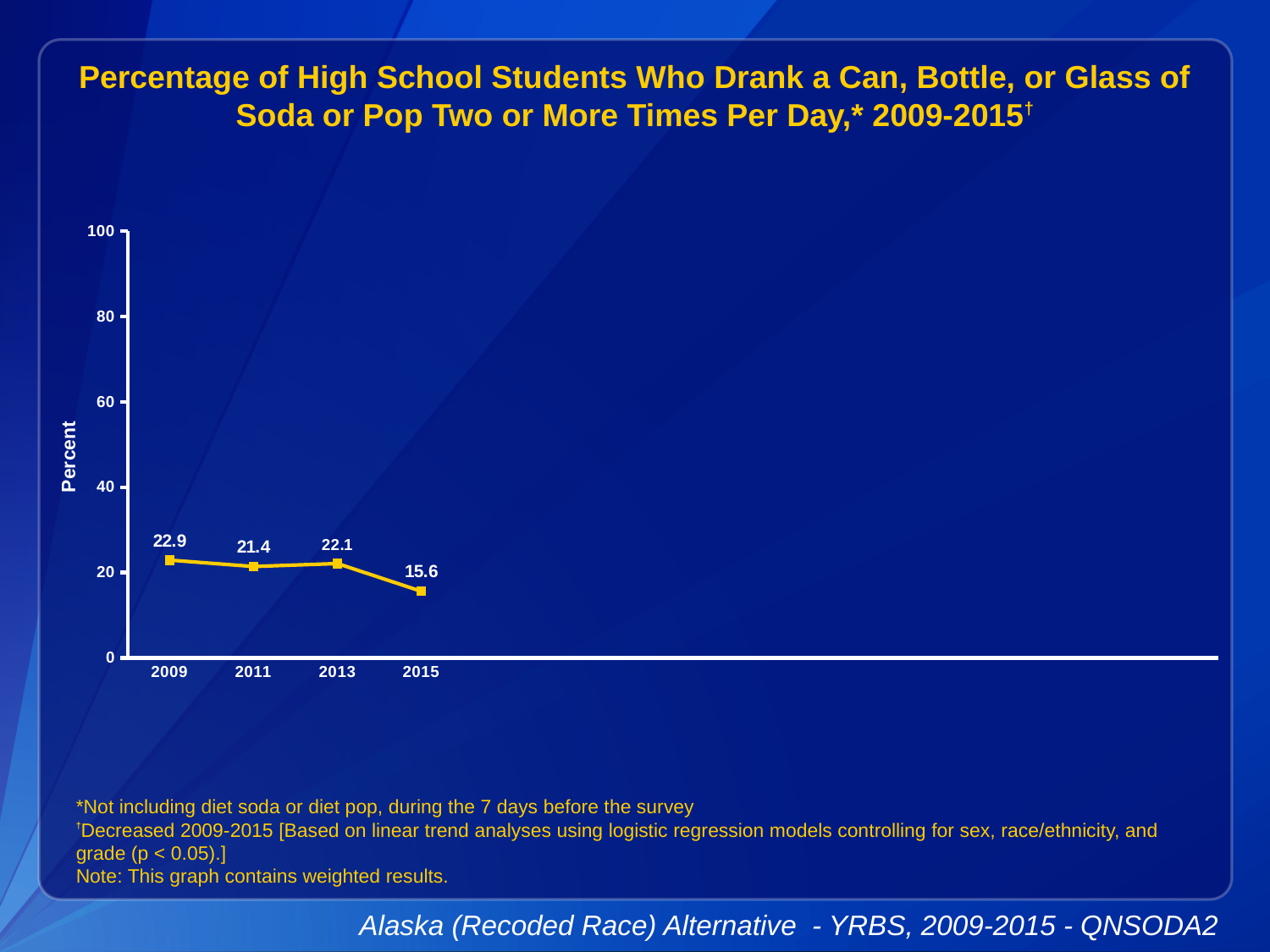
Which is larger, the value for 2011 or the value for 2013? 2013 What is the label on the vertical axis? Percent What percentage of high school students drank soda or pop two or more times per day in 2009? 22.9 What is the value plotted for 2011? 21.4 Do the values generally rise or fall from 2009 to 2015? fall What is the difference between the 2009 value and the 2015 value? 7.3 Is the value for 2013 greater or less than 40? less Which year has the highest percentage? 2009 Which year has the lowest percentage? 2015 What kind of chart is shown on the slide? line chart What is the value plotted for 2015? 15.6 How many years are plotted on the chart? 4